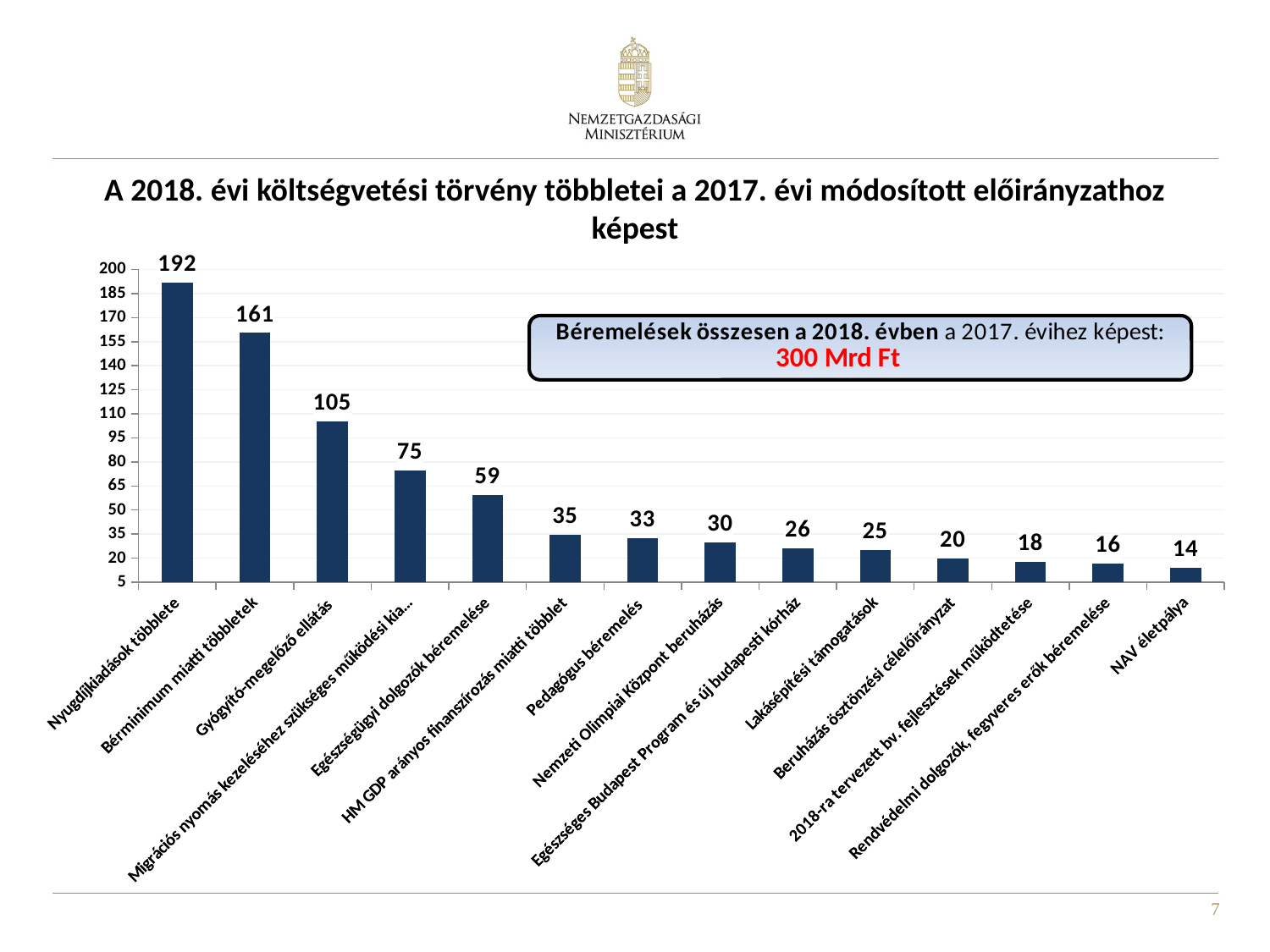
What kind of chart is shown on the slide? Bar chart What is the value for Pedagógus béremelés? 33 What total amount for wage increases in 2018 is stated in the text box on the chart? 300 Mrd Ft Which is larger: the value for Gyógyító-megelőző ellátás or the value for Egészségügyi dolgozók béremelése? Gyógyító-megelőző ellátás What is the value for Lakásépítési támogatások? 25 What is the value for Nyugdíjkiadások többlete? 192 Which category has the lowest value? NAV életpálya Do the values rise or fall from left to right along the x axis? Fall What is the difference between the values for Nyugdíjkiadások többlete and Bérminimum miatti többletek? 31 How many categories are shown in the chart? 14 What is the value for NAV életpálya? 14 Which category has the highest value? Nyugdíjkiadások többlete